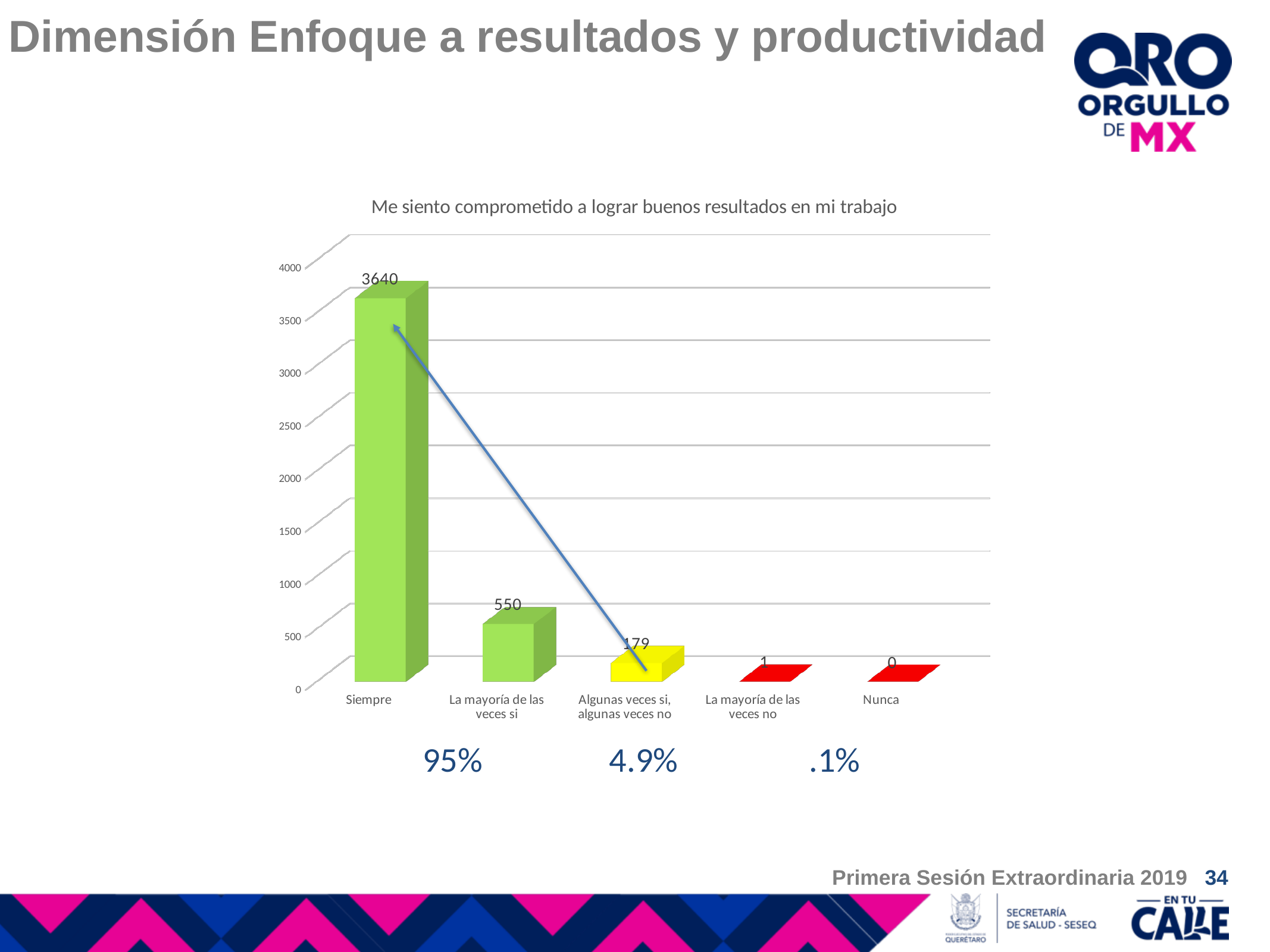
What is the title of the chart? Me siento comprometido a lograr buenos resultados en mi trabajo Which category has the lowest value? Nunca What is the value for La mayoría de las veces si? 550 What is the difference between the values for Siempre and La mayoría de las veces si? 3090 Which is larger, the value for La mayoría de las veces si or the value for Algunas veces si, algunas veces no? La mayoría de las veces si What kind of chart is shown? bar chart Is the value for Siempre greater or less than 3500? greater What is the value for Algunas veces si, algunas veces no? 179 What is the value for Nunca? 0 What is the value for Siempre? 3640 How many categories are shown on the x axis? 5 Which category has the highest value? Siempre